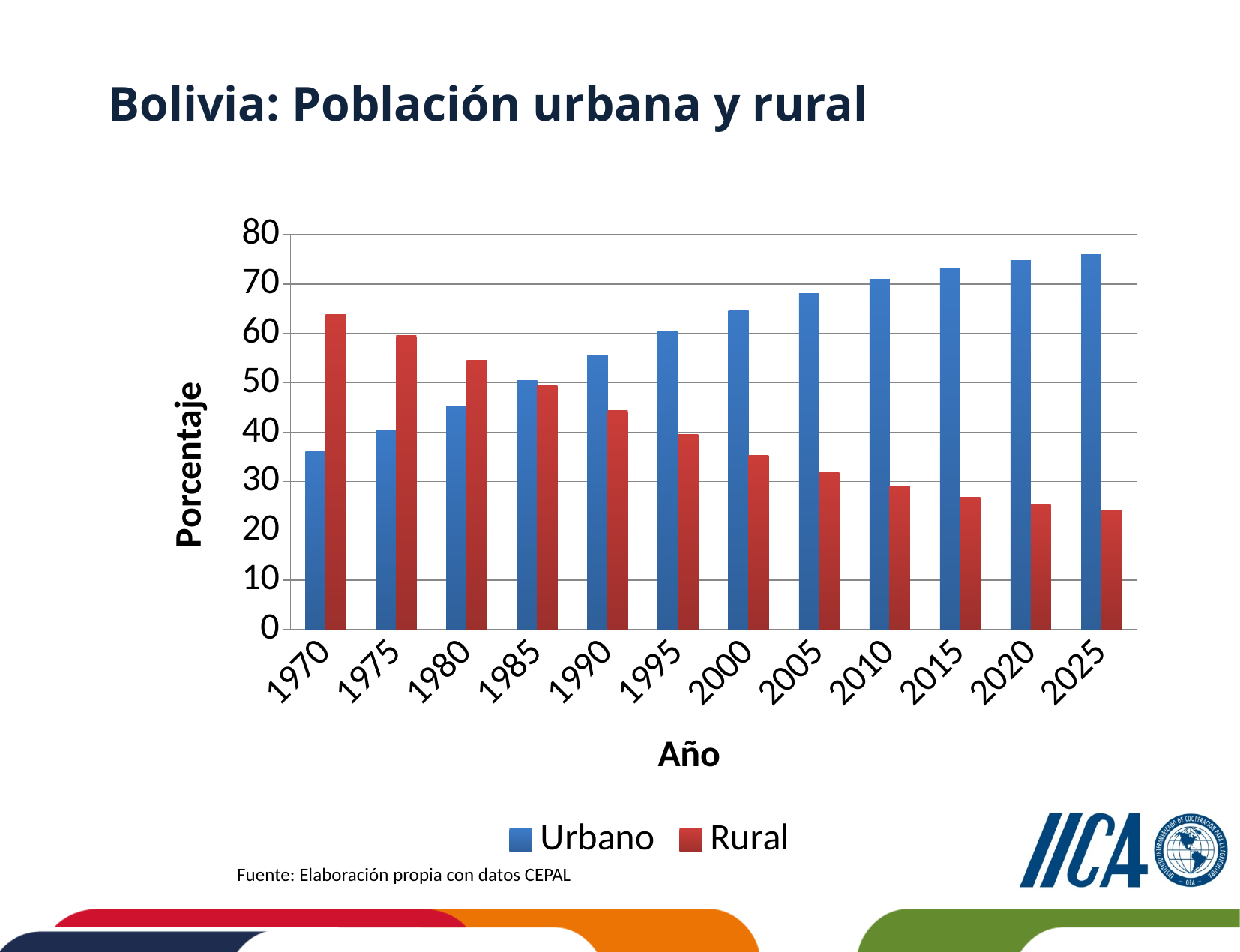
In 1980, which is larger, the Urbano value or the Rural value? Rural Does the Rural series rise or fall from 1970 to 2025? fall Is the Rural value for 2025 greater or less than 30? less How many series does the legend list? 2 In which year is the Rural value lowest? 2025 In which year is the Urbano value highest? 2025 What kind of chart is shown on the slide? bar chart Is the Urbano value for 1970 greater or less than 30? greater Is the Urbano value for 2025 greater or less than 70? greater How many years are shown on the x axis? 12 What is the label of the y axis? Porcentaje In which year is the Rural value highest? 1970